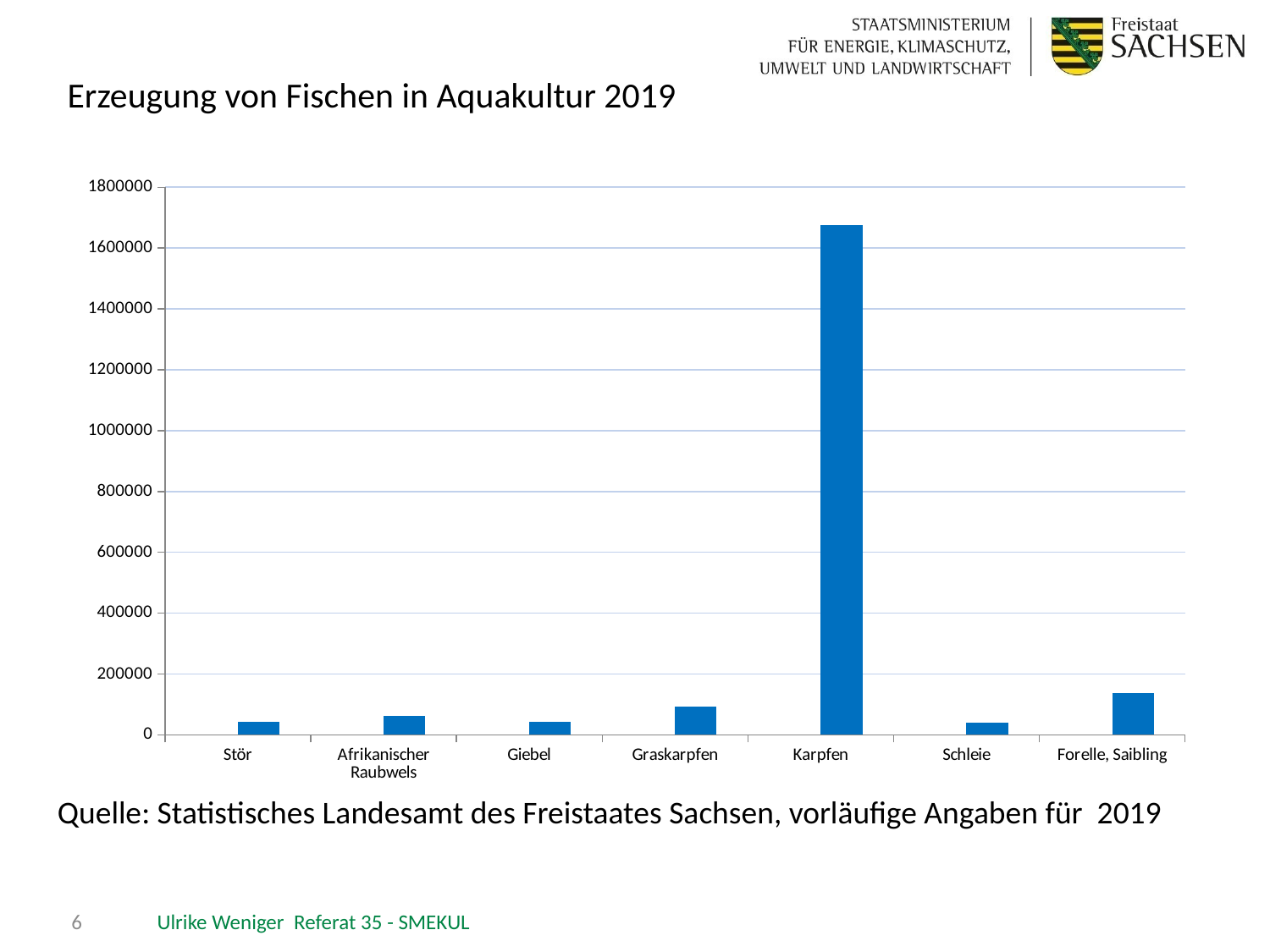
Is the value for Karpfen greater or less than 1800000? less What kind of chart is shown on the slide? bar chart What is the highest value shown on the y axis? 1800000 Which is larger, the value for Graskarpfen or the value for Giebel? Graskarpfen Is the value for Forelle, Saibling greater or less than 200000? less Which is larger, the value for Forelle, Saibling or the value for Graskarpfen? Forelle, Saibling How many fish categories are shown on the x axis? 7 Is the value for Graskarpfen greater or less than 200000? less Which is larger, the value for Karpfen or the value for Forelle, Saibling? Karpfen What is the title of the chart on the slide? Erzeugung von Fischen in Aquakultur 2019 Which category has the highest value? Karpfen